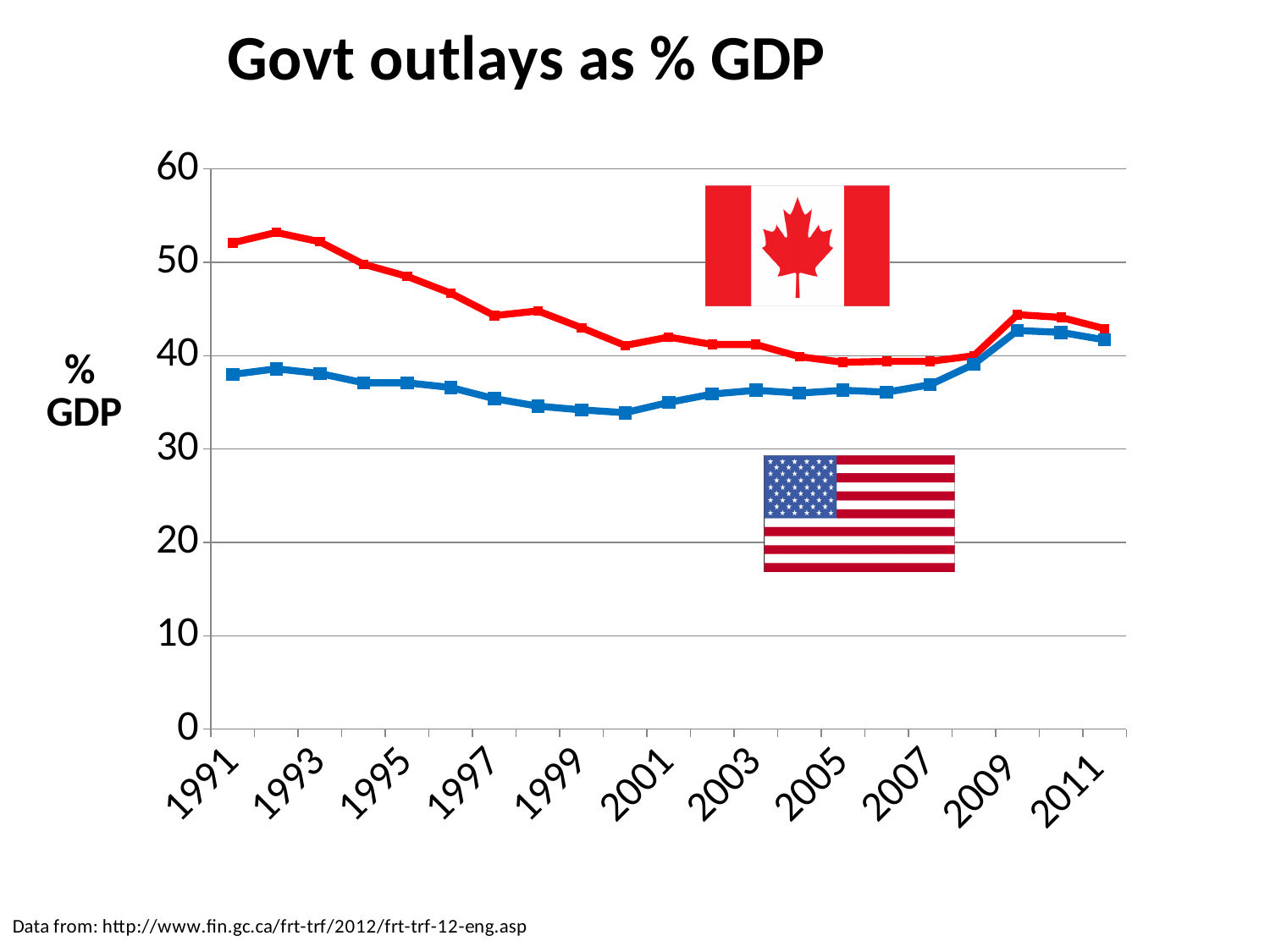
What is the title of the chart? Govt outlays as % GDP In 1991, which country has the higher government outlays as % GDP, Canada or the US? Canada Does the Canada (red) line rise or fall from 1991 to 2000? fall Is the value for the US (blue line) in 2000 greater or less than 40? less Is the value for Canada (red line) in 2009 greater or less than 40? greater Does the US (blue) line rise or fall from 2000 to 2009? rise What kind of chart is shown on the slide? line chart How many lines are plotted on the chart? 2 How many data points does each line have? 21 Is the value for the US (blue line) in 2009 greater or less than 40? greater In which year does the Canada (red) line reach its highest value? 1992